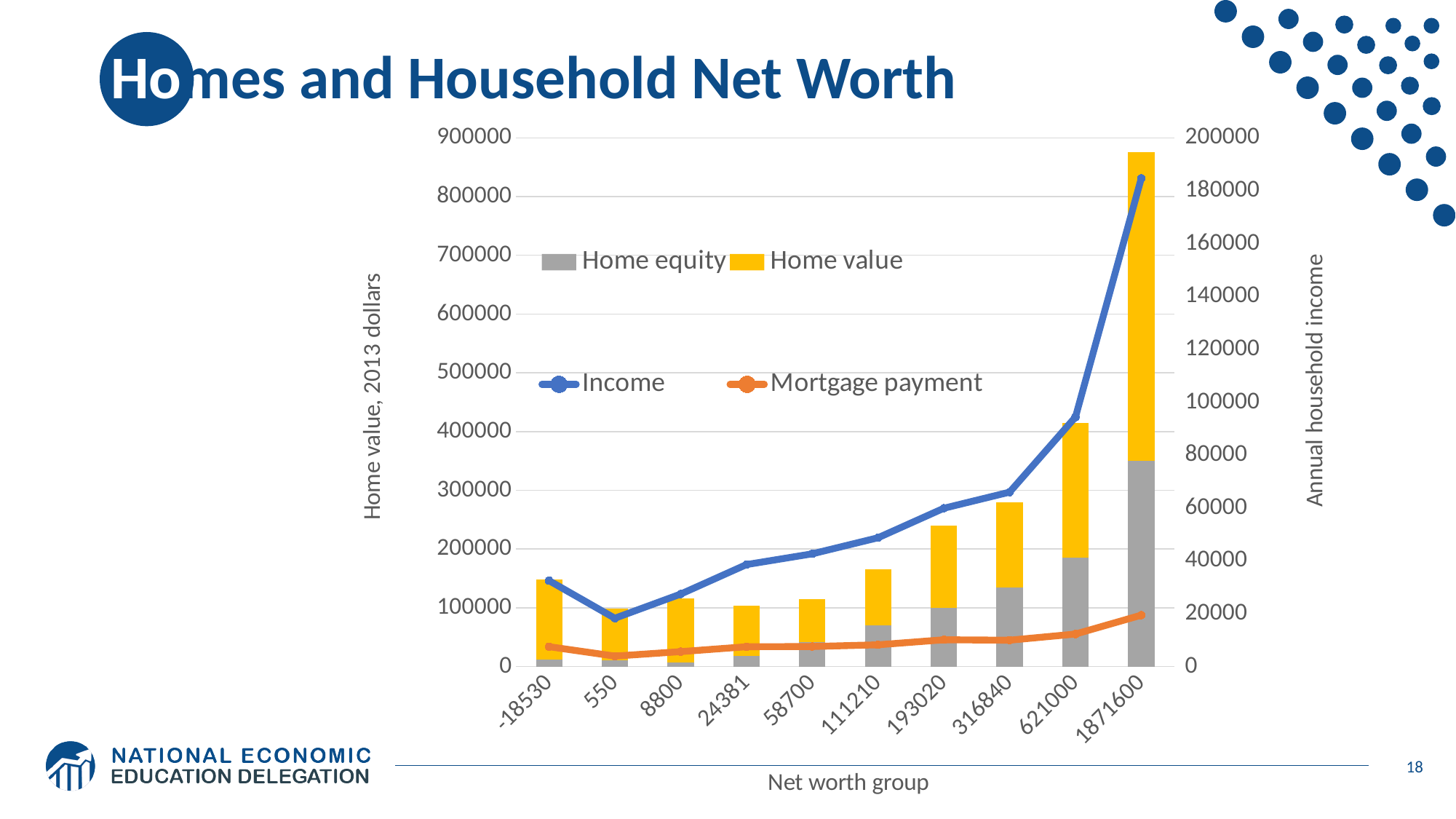
How many series does the legend list? 4 Which net worth group has the highest Income? 1871600 Which net worth group has the lowest Income? 550 Does Income generally rise or fall across the net worth groups from 550 to 1871600? Rise Which is larger, the Home value for the 621000 group or for the 316840 group? 621000 Is the Home equity for the 621000 net worth group greater or less than 100000? greater How many net worth groups are shown on the x axis? 10 Which net worth group has the highest Home value? 1871600 What is the title of the left vertical axis? Home value, 2013 dollars Is the Income for the 1871600 net worth group greater or less than 160000 on the right axis? greater What kind of chart is shown on the slide? A combination chart with stacked bars and lines